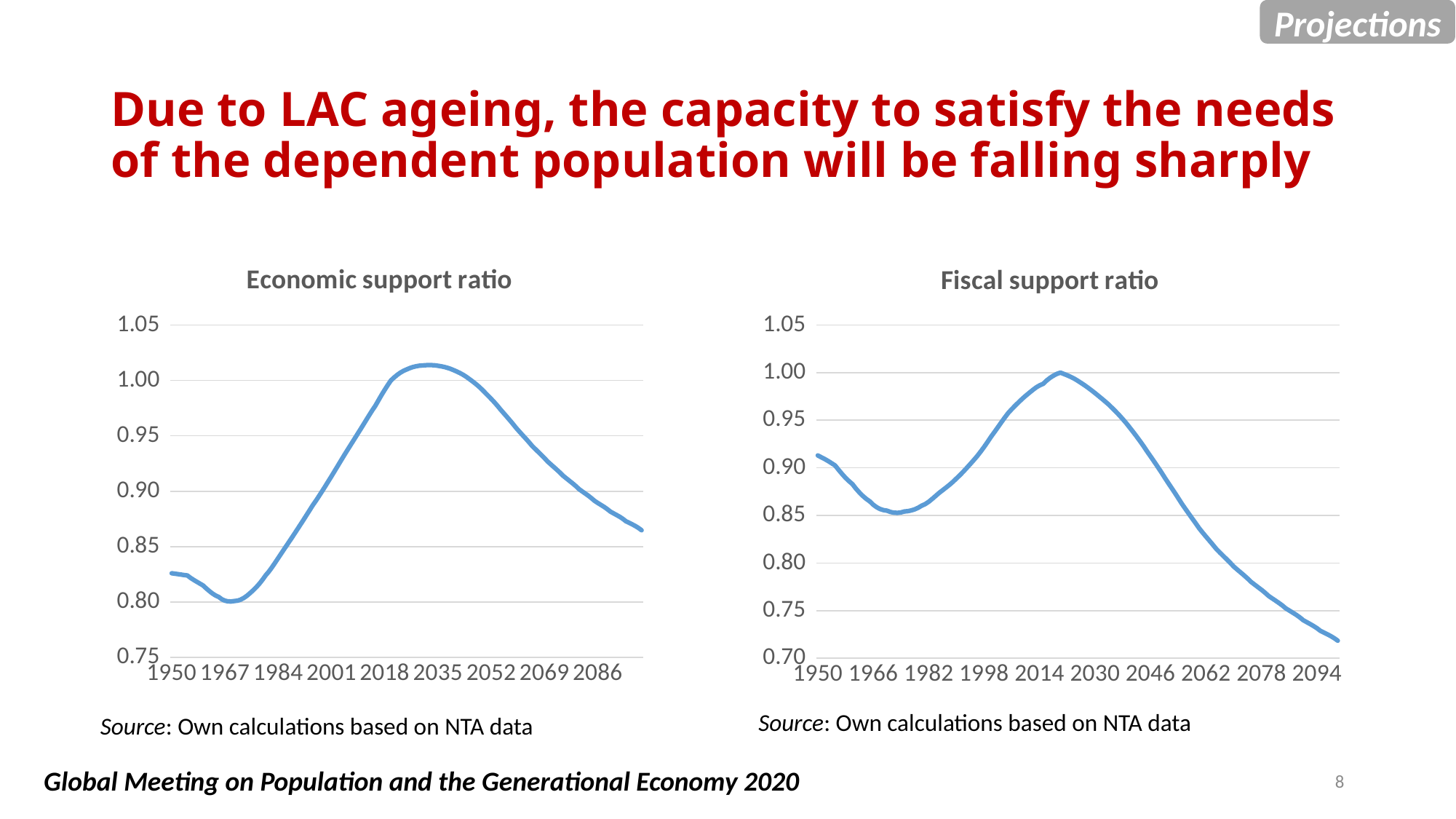
How many charts are shown on the slide? 2 In the Economic support ratio chart, is the value for 2086 greater or less than 0.90? less In the Fiscal support ratio chart, is the value for 2062 greater or less than 0.85? less In the Economic support ratio chart, is the value for 2035 greater or less than 1.00? greater What kind of chart is the Economic support ratio chart? line chart In the Fiscal support ratio chart, which year has the larger value, 1950 or 2094? 1950 What kind of chart is the Fiscal support ratio chart? line chart In the Economic support ratio chart, does the line rise or fall between 2035 and 2086? fall What is the title of the chart on the right side of the slide? Fiscal support ratio In the Fiscal support ratio chart, does the line rise or fall between 1982 and 2014? rise